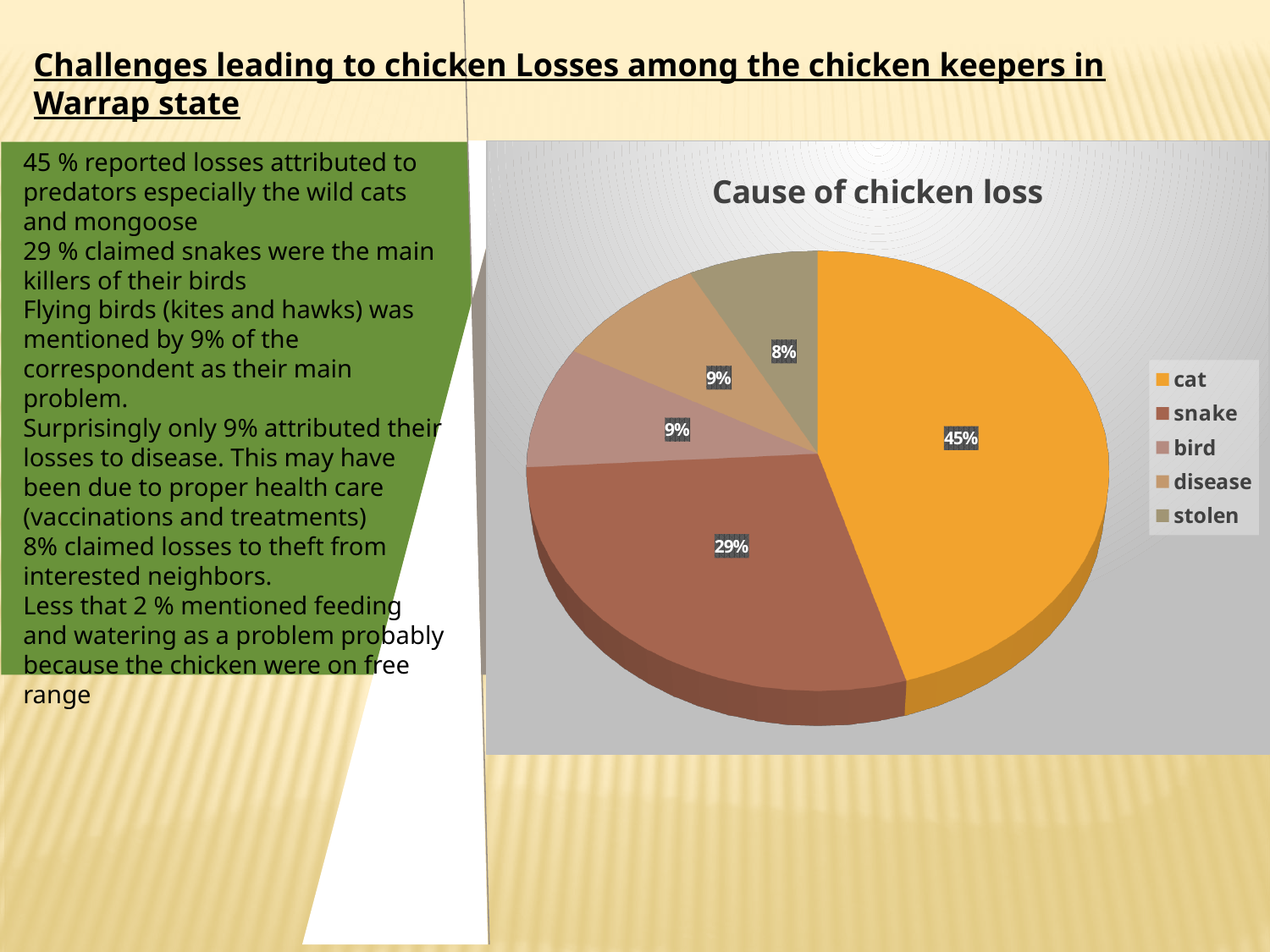
What is the title of the chart? Cause of chicken loss What percentage of chicken loss is attributed to stolen? 8% What percentage of chicken loss is attributed to snake? 29% Which legend entry is shown in orange? cat Which cause accounts for the largest share of chicken loss? cat What is the combined share of cat and snake? 74% What type of chart is shown on the slide? pie chart What percentage of chicken loss is attributed to cat? 45% What percentage of chicken loss is attributed to bird? 9% How many categories does the legend list? 5 What is the difference between the cat share and the snake share? 16% Which is larger, the share for snake or the share for disease? snake